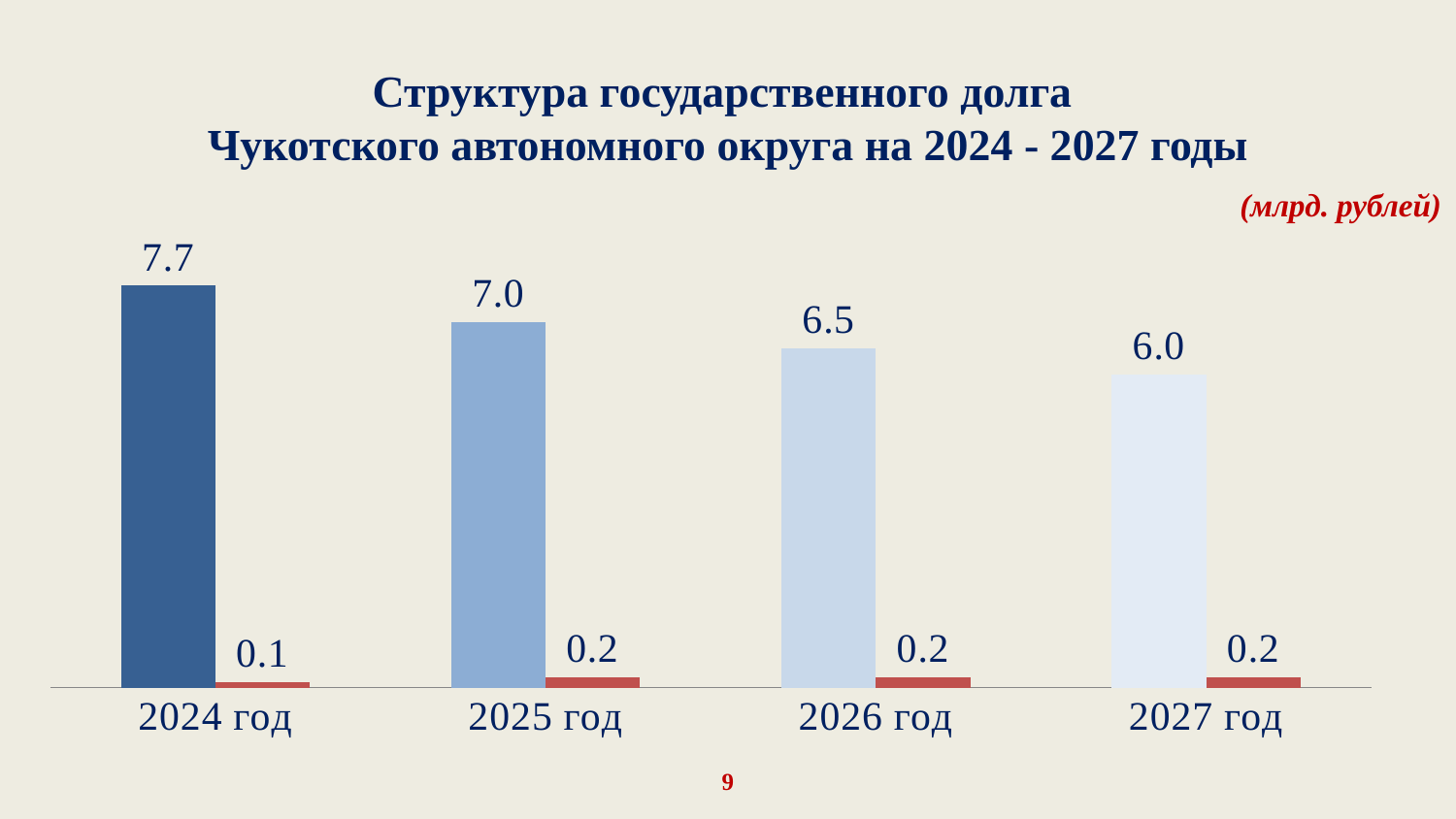
What is the value of the small red bar for 2024 год? 0.1 What is the difference between the blue bar values for 2025 год and 2026 год? 0.5 What is the value of the tall blue bar for 2024 год? 7.7 What kind of chart is shown on the slide? Bar chart Which year has the highest value for the tall blue bars? 2024 год Which is larger, the blue bar for 2025 год or the blue bar for 2026 год? 2025 год How many years are shown on the x axis? 4 What is the value of the tall blue bar for 2027 год? 6.0 What is the difference between the blue bar values for 2024 год and 2027 год? 1.7 What is the value of the small red bar for 2026 год? 0.2 Which year has the lowest value for the tall blue bars? 2027 год Do the values of the tall blue bars rise or fall from 2024 год to 2027 год? Fall